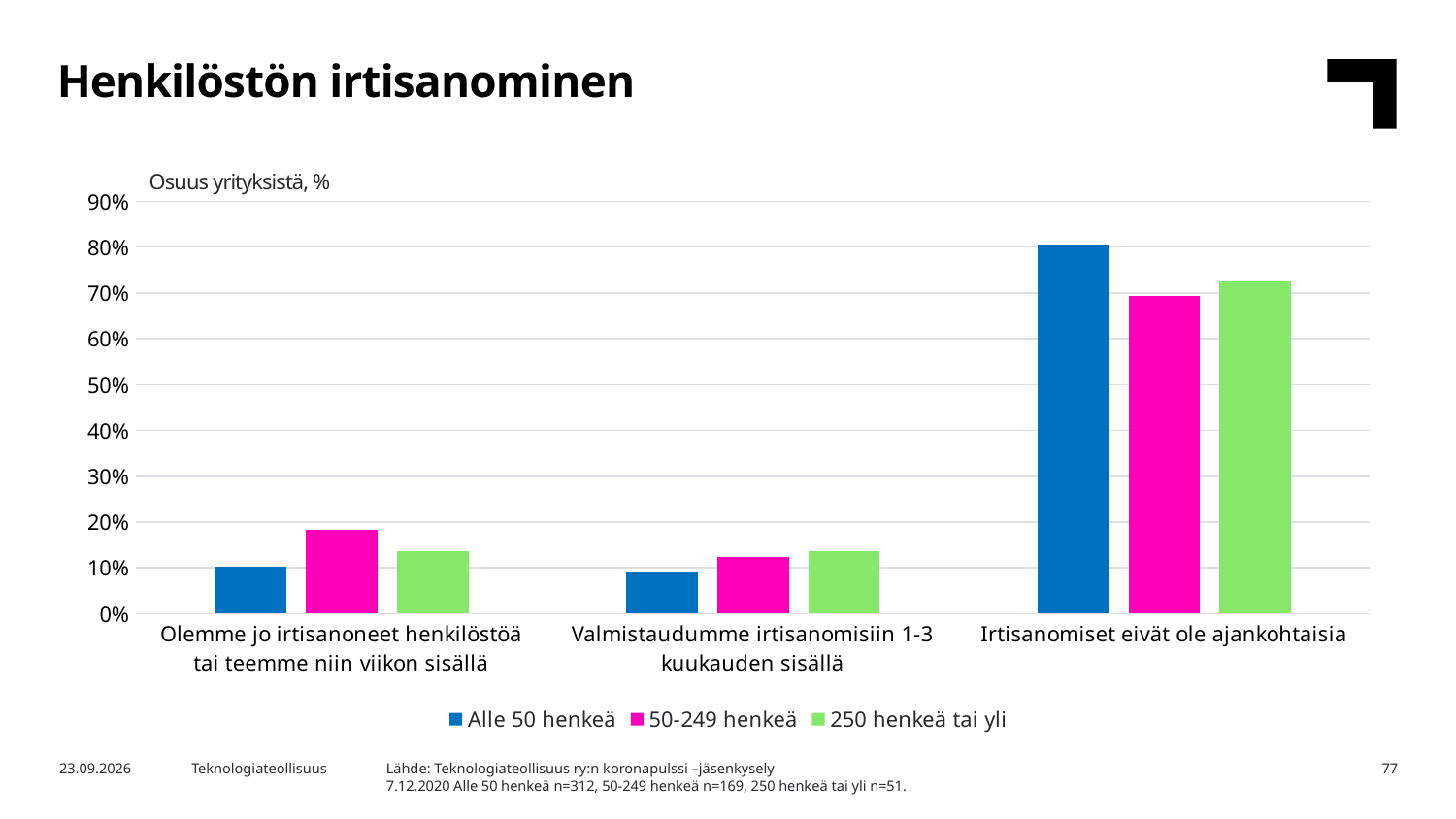
Which series has the highest bar in the category 'Irtisanomiset eivät ole ajankohtaisia'? Alle 50 henkeä What is the title of the chart on the slide? Henkilöstön irtisanominen Is the value for 'Alle 50 henkeä' in the category 'Irtisanomiset eivät ole ajankohtaisia' greater or less than 70%? greater What label is shown above the vertical axis of the chart? Osuus yrityksistä, % How many series does the legend list? 3 Is the value for '250 henkeä tai yli' in the category 'Olemme jo irtisanoneet henkilöstöä tai teemme niin viikon sisällä' greater or less than 20%? less In the category 'Irtisanomiset eivät ole ajankohtaisia', which is larger: the value for 'Alle 50 henkeä' or for '50-249 henkeä'? Alle 50 henkeä Which series has the lowest bar in the category 'Valmistaudumme irtisanomisiin 1-3 kuukauden sisällä'? Alle 50 henkeä What kind of chart is shown on the slide? bar chart Is the value for '50-249 henkeä' in the category 'Irtisanomiset eivät ole ajankohtaisia' greater or less than 80%? less How many categories are shown on the x axis? 3 Which series has the highest bar in the category 'Olemme jo irtisanoneet henkilöstöä tai teemme niin viikon sisällä'? 50-249 henkeä